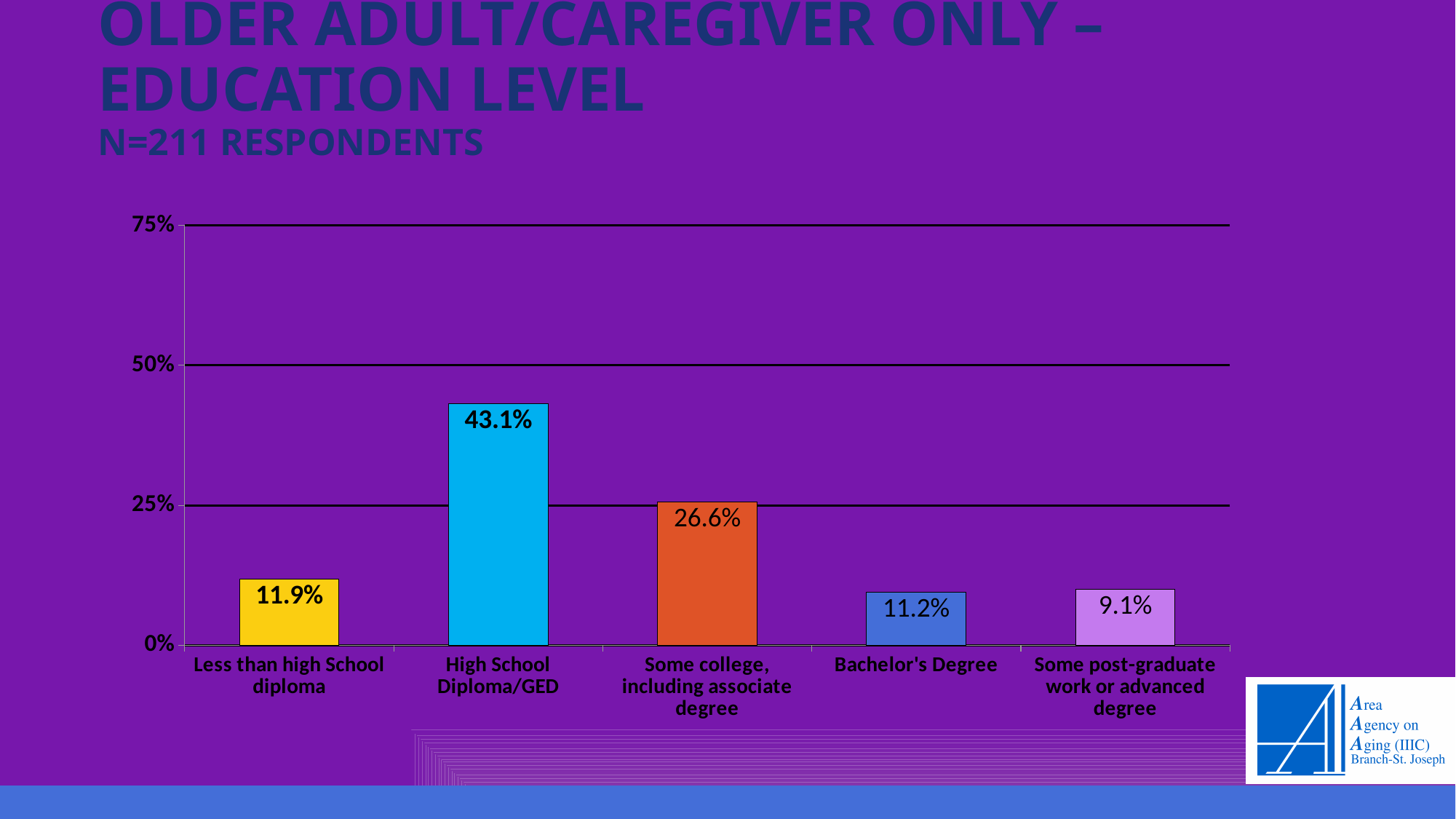
Which education level has the highest percentage of respondents? High School Diploma/GED What percentage of respondents have a High School Diploma/GED? 43.1% What kind of chart is shown on the slide? Bar chart What percentage of respondents have some college, including associate degree? 26.6% What percentage of respondents have some post-graduate work or advanced degree? 9.1% What is the difference in percentage points between High School Diploma/GED and Some college, including associate degree? 16.5 Is the value for High School Diploma/GED greater or less than 50%? less How many education level categories are shown in the chart? 5 Which is larger: the percentage for Bachelor's Degree or for Less than high School diploma? Less than high School diploma How many respondents does the slide say the chart is based on? 211 What percentage of respondents have less than a high school diploma? 11.9%